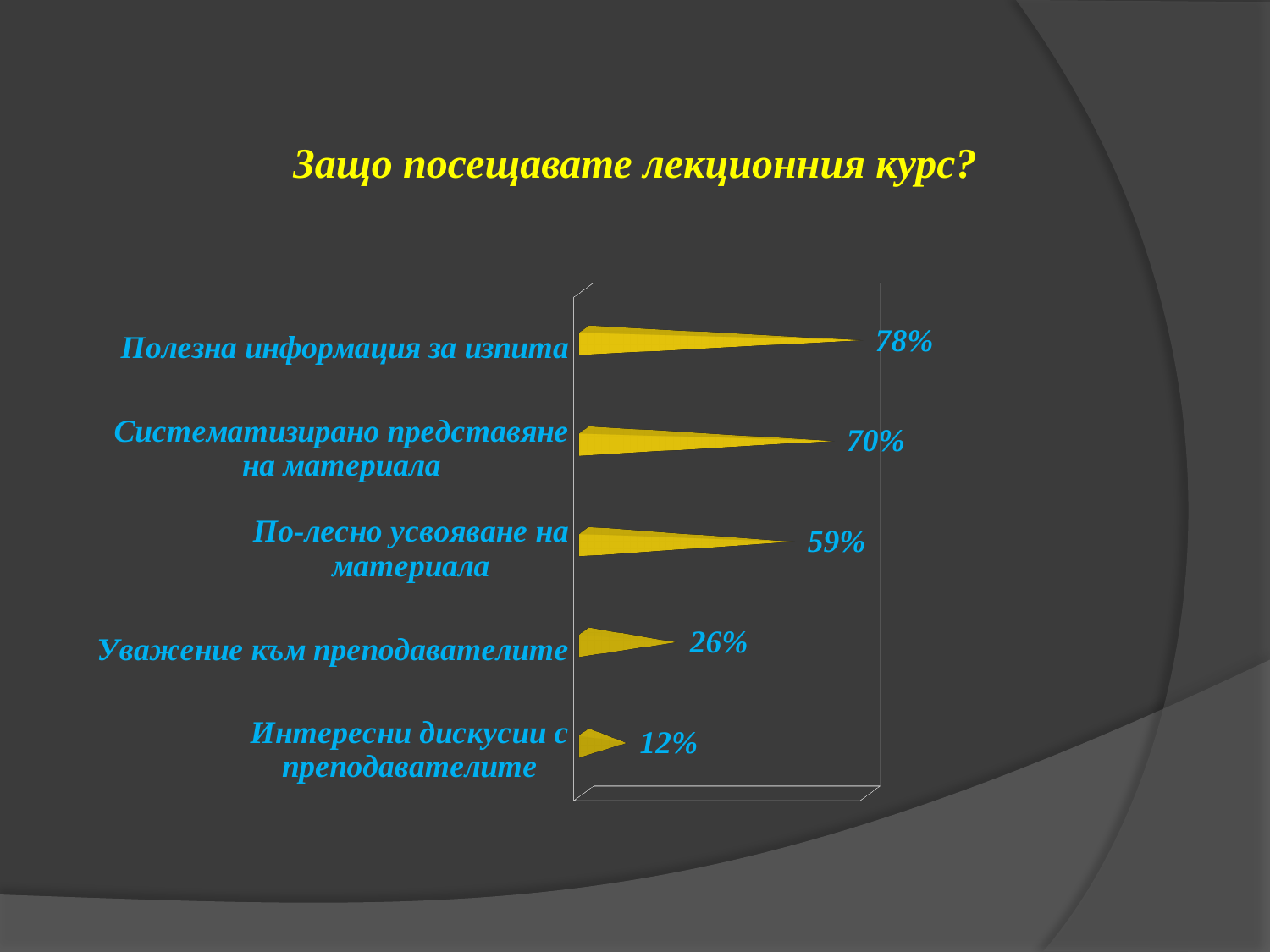
Which is larger: the value for "Систематизирано представяне на материала" or for "По-лесно усвояване на материала"? Систематизирано представяне на материала Which category has the lowest value? Интересни дискусии с преподавателите What is the difference between the values for "Уважение към преподавателите" and "Интересни дискусии с преподавателите"? 14% What is the value for "По-лесно усвояване на материала"? 59% What is the value for "Интересни дискусии с преподавателите"? 12% What is the title of the chart? Защо посещавате лекционния курс? What is the value for "Полезна информация за изпита"? 78% What is the difference between the values for "Полезна информация за изпита" and "Систематизирано представяне на материала"? 8% Which category has the highest value? Полезна информация за изпита How many categories are shown in the chart? 5 What kind of chart is shown on the slide? Bar chart What is the value for "Уважение към преподавателите"? 26%